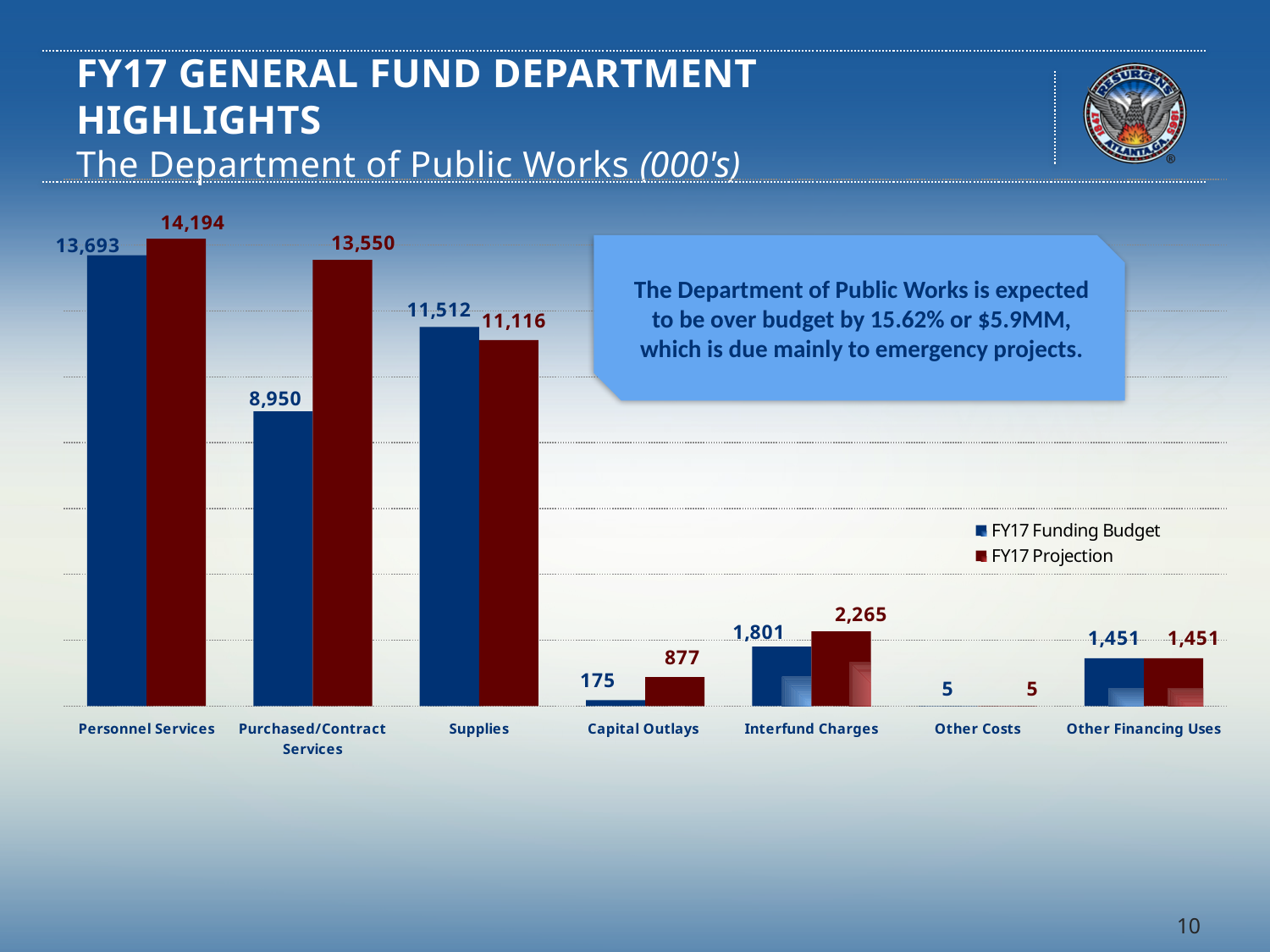
What kind of chart is shown on the slide? Bar chart How many series does the legend list? 2 What is the difference between the FY17 Projection and the FY17 Funding Budget for Purchased/Contract Services? 4,600 Which colour represents the FY17 Projection series in the chart? Dark red What is the FY17 Funding Budget value for Personnel Services? 13,693 What is the difference between the FY17 Projection and the FY17 Funding Budget for Interfund Charges? 464 Which category has the highest FY17 Projection value? Personnel Services What is the FY17 Projection value for Purchased/Contract Services? 13,550 Which category has the lowest FY17 Funding Budget value? Other Costs What is the FY17 Projection value for Capital Outlays? 877 How many categories are shown on the x axis of the chart? 7 For Supplies, which is larger: the FY17 Funding Budget or the FY17 Projection? FY17 Funding Budget